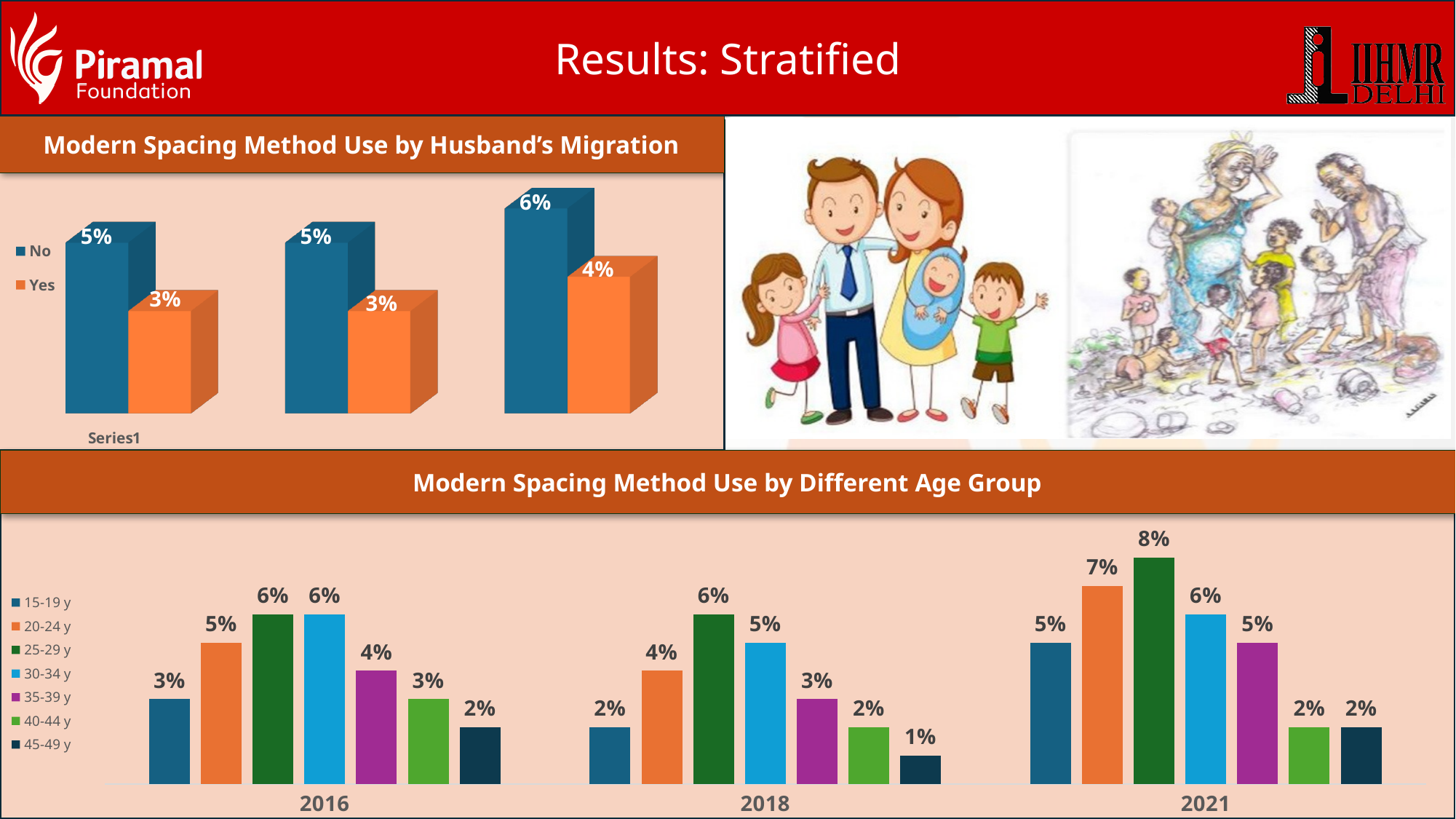
In the 'Modern Spacing Method Use by Different Age Group' chart, what is the value for the 20-24 y group in 2016? 5% How many years are shown on the x axis of the 'Modern Spacing Method Use by Different Age Group' chart? 3 In the 'Modern Spacing Method Use by Different Age Group' chart, which is larger: the 15-19 y value in 2016 or the 15-19 y value in 2021? 2021 What kind of chart is 'Modern Spacing Method Use by Husband's Migration'? bar chart How many series does the legend of the 'Modern Spacing Method Use by Different Age Group' chart list? 7 In the 'Modern Spacing Method Use by Different Age Group' chart, what is the value for the 25-29 y group in 2021? 8% In the 'Modern Spacing Method Use by Different Age Group' chart, does the value for the 25-29 y group rise or fall from 2018 to 2021? rise In the 'Modern Spacing Method Use by Different Age Group' chart, which age group has the lowest value in 2018? 45-49 y In the 'Modern Spacing Method Use by Different Age Group' chart, which age group has the highest value in 2021? 25-29 y In the 'Modern Spacing Method Use by Different Age Group' chart, what is the value for the 45-49 y group in 2018? 1% In the 'Modern Spacing Method Use by Husband's Migration' chart, what is the 'No' value for the group labelled Series1? 5% In the 'Modern Spacing Method Use by Different Age Group' chart, what is the difference between the 20-24 y value in 2021 and the 20-24 y value in 2018? 3%